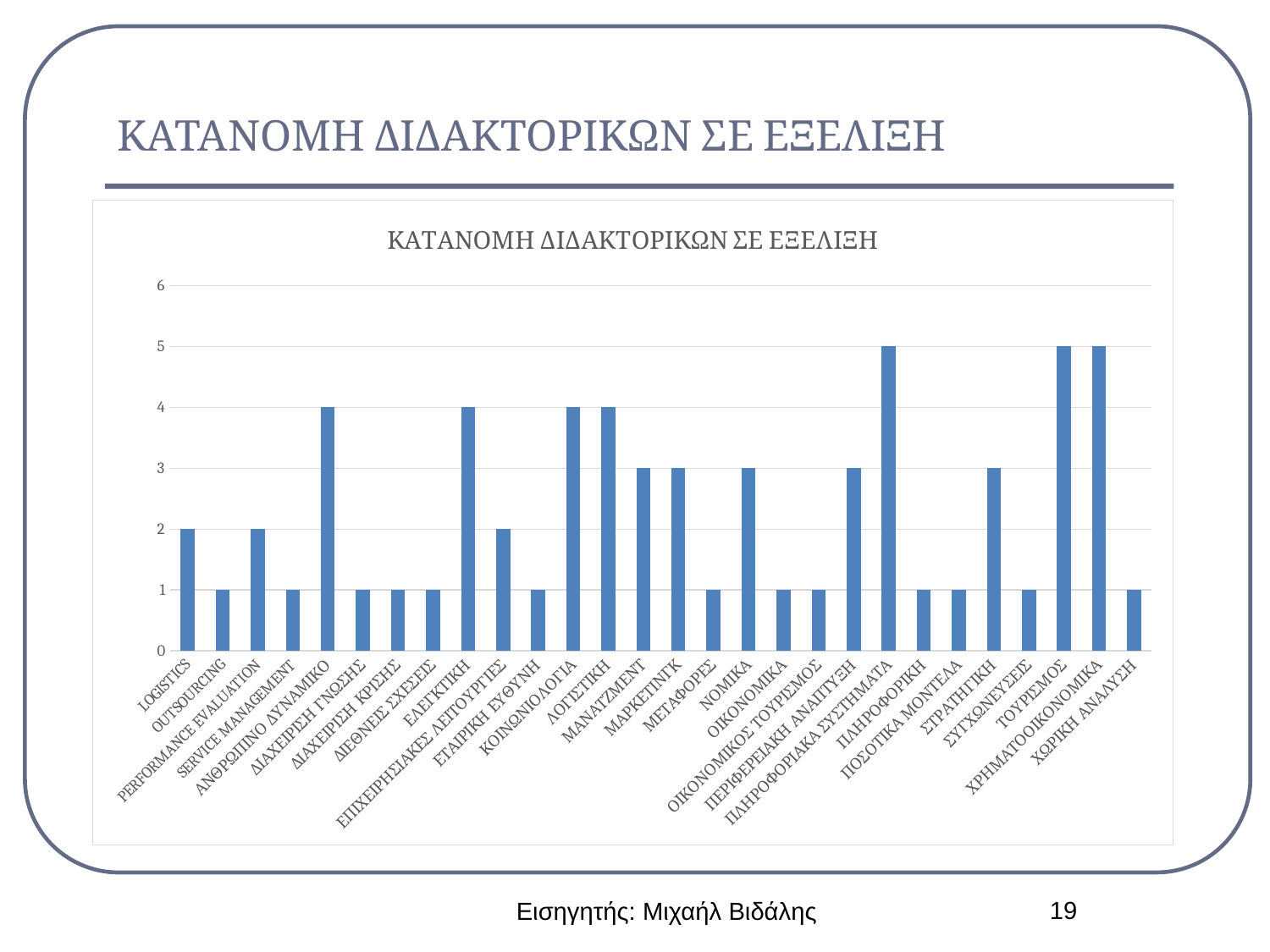
What is the value for ΠΛΗΡΟΦΟΡΙΑΚΑ ΣΥΣΤΗΜΑΤΑ? 5 What is the value for LOGISTICS? 2 How many categories are shown on the x axis of the chart? 28 What is the highest value reached by any bar in the chart? 5 What is the title of the chart? ΚΑΤΑΝΟΜΗ ΔΙΔΑΚΤΟΡΙΚΩΝ ΣΕ ΕΞΕΛΙΞΗ Which has a larger value, ΕΛΕΓΚΤΙΚΗ or ΜΑΡΚΕΤΙΝΓΚ? ΕΛΕΓΚΤΙΚΗ What is the value for ΜΑΝΑΤΖΜΕΝΤ? 3 What is the difference between the values for ΤΟΥΡΙΣΜΟΣ and ΣΥΓΧΩΝΕΥΣΕΙΣ? 4 What is the value for ΑΝΘΡΩΠΙΝΟ ΔΥΝΑΜΙΚΟ? 4 What is the value for OUTSOURCING? 1 What type of chart is shown on the slide? Bar chart Is the value for ΧΡΗΜΑΤΟΟΙΚΟΝΟΜΙΚΑ greater or less than 3? greater